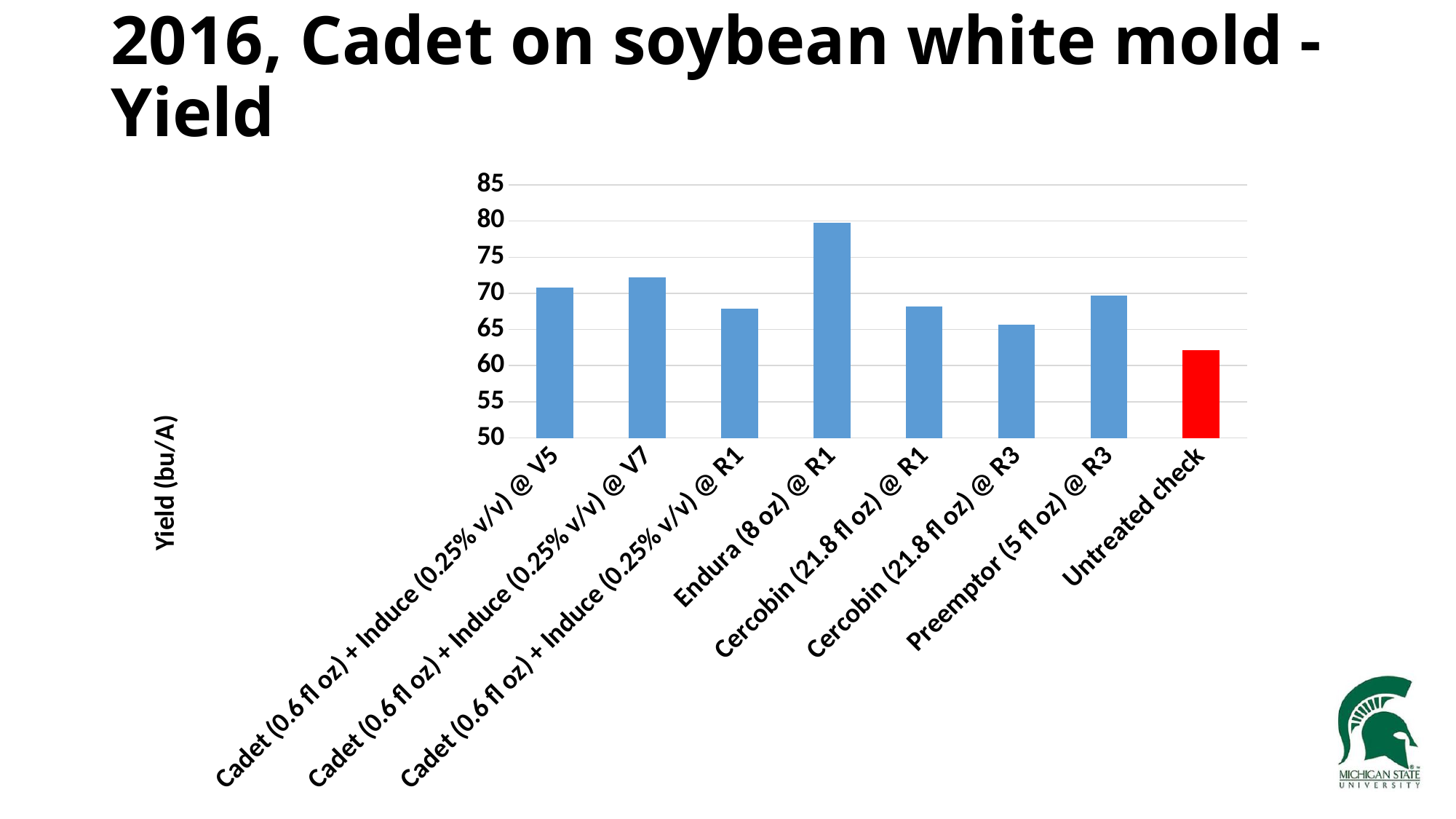
Which treatment has the highest yield? Endura (8 oz) @ R1 How many treatments (bars) are plotted in the chart? 8 Which treatment has the lowest yield? Untreated check Which bar in the chart is coloured red? Untreated check Which has the higher yield: Cadet (0.6 fl oz) + Induce (0.25% v/v) @ V7 or Cadet (0.6 fl oz) + Induce (0.25% v/v) @ R1? Cadet (0.6 fl oz) + Induce (0.25% v/v) @ V7 Is the yield for the Untreated check greater or less than 65? less Is the yield for Cadet (0.6 fl oz) + Induce (0.25% v/v) @ V7 greater or less than 70? greater Is the yield for Endura (8 oz) @ R1 greater or less than 75? greater What is the label on the vertical axis of the chart? Yield (bu/A) Which has the higher yield: Preemptor (5 fl oz) @ R3 or Cercobin (21.8 fl oz) @ R3? Preemptor (5 fl oz) @ R3 What kind of chart is shown on the slide? bar chart